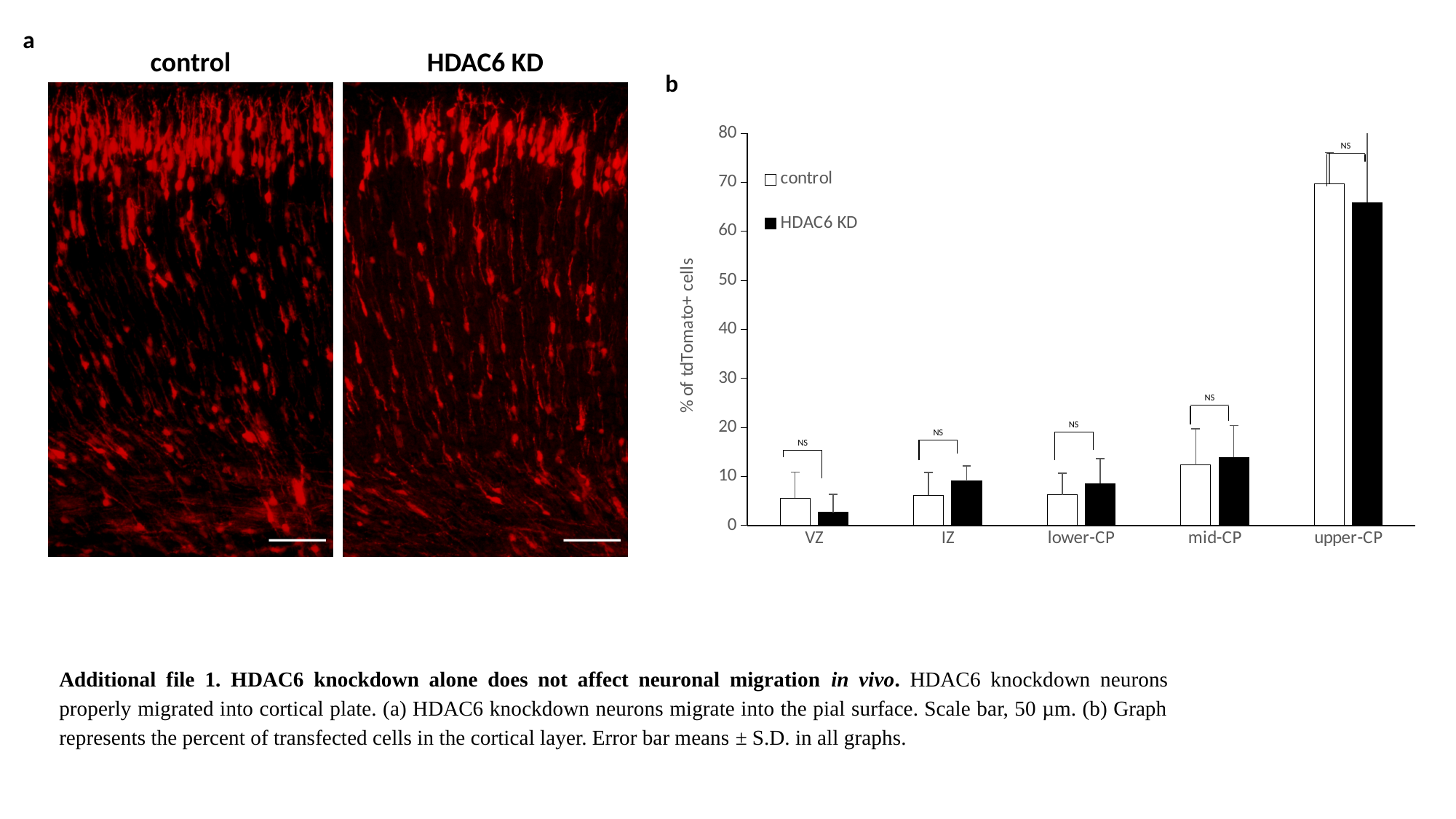
In the chart in panel b, which is larger for VZ: the control value or the HDAC6 KD value? control In the chart in panel b, is the control value for upper-CP greater or less than 60? greater What kind of chart is shown in panel b? bar chart In the chart in panel b, which category has the highest value for the HDAC6 KD series? upper-CP In the chart in panel b, which category has the highest value for the control series? upper-CP How many series does the legend of the chart in panel b list? 2 In the chart in panel b, which series is shown with black bars? HDAC6 KD How many categories are shown on the x axis of the chart in panel b? 5 In the chart in panel b, which category has the lowest value for the HDAC6 KD series? VZ In the chart in panel b, is the HDAC6 KD value for VZ greater or less than 10? less In the chart in panel b, is the HDAC6 KD value for mid-CP greater or less than 20? less What is the y-axis label of the chart in panel b? % of tdTomato+ cells